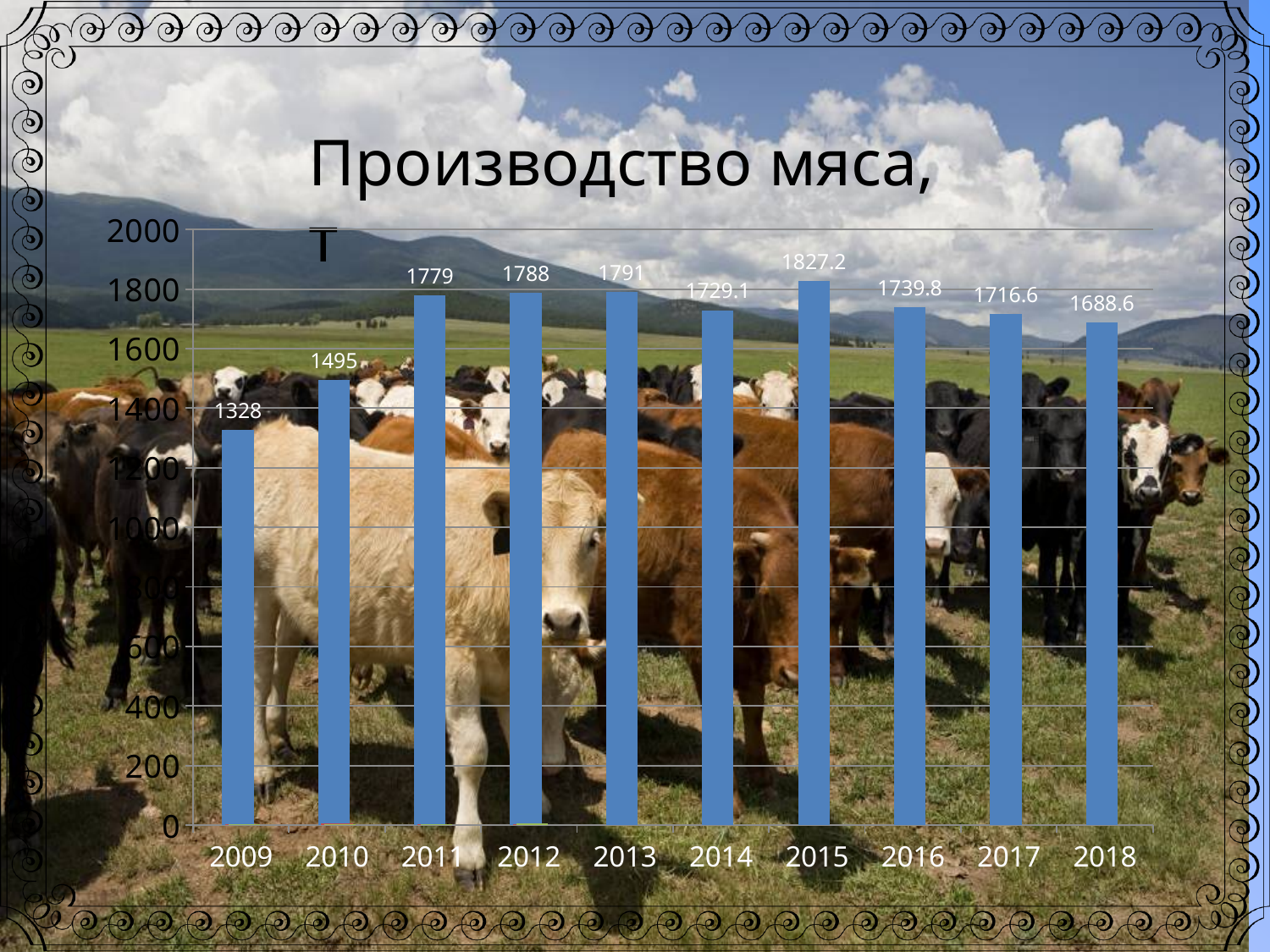
What is the title of the chart? Производство мяса, т What is the difference between the values for 2010 and 2009? 167 Which is larger, the value for 2016 or the value for 2017? 2016 Is the value for 2010 greater or less than 1600? less What kind of chart is this? bar chart What is the value for 2014? 1729.1 How many years are shown on the x axis? 10 Which year has the lowest value? 2009 What is the value for 2009? 1328 Which year has the highest value? 2015 What is the value for 2015? 1827.2 What is the value for 2018? 1688.6